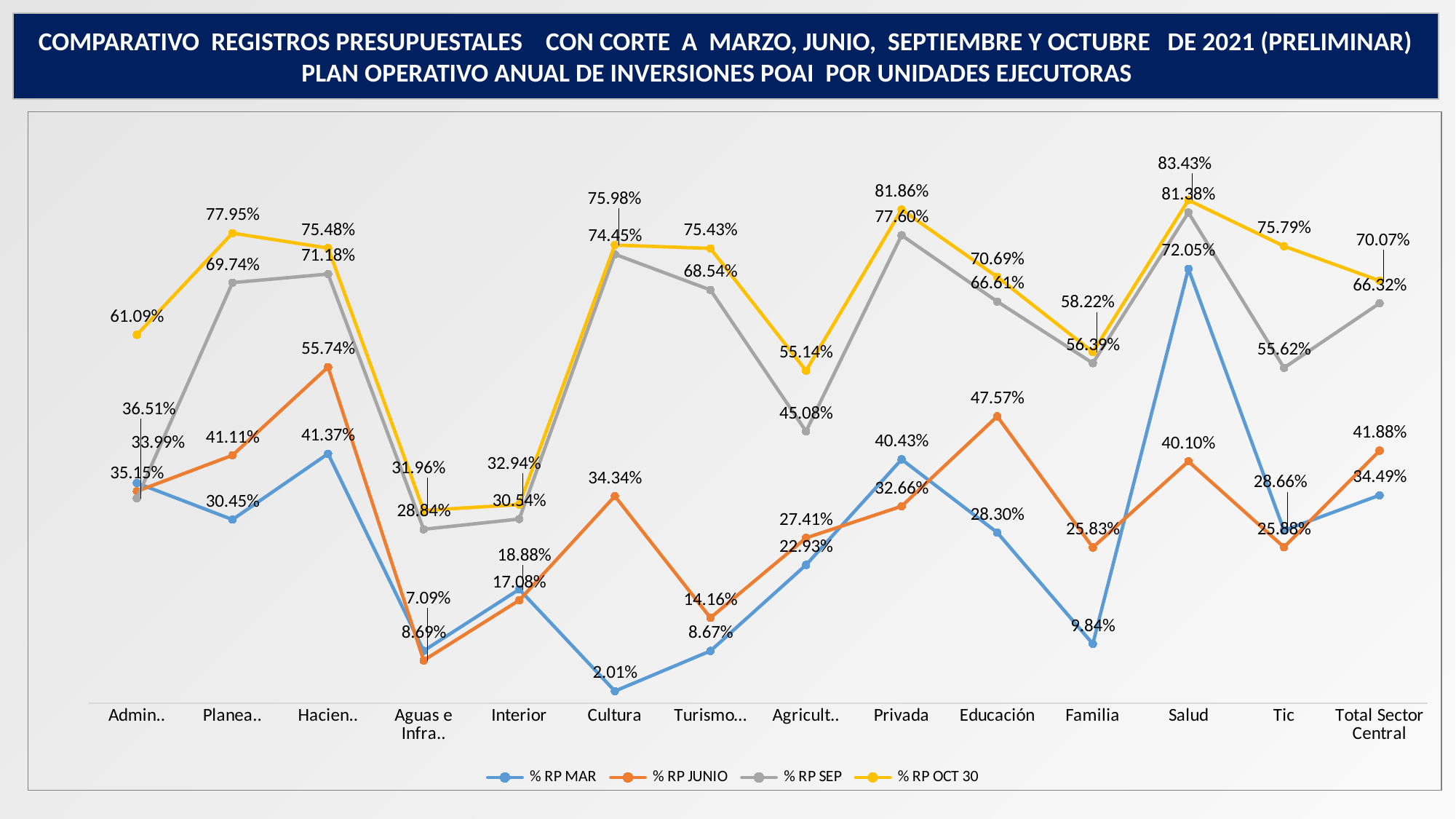
Which category has the lowest % RP MAR value? Cultura How many series does the legend list? 4 What is the difference between the % RP OCT 30 and % RP SEP values for Salud? 2.05 percentage points What colour is the % RP OCT 30 line? Yellow How many categories are shown along the x axis? 14 What kind of chart is shown on the slide? Line chart Which category has the highest % RP OCT 30 value? Salud What is the % RP SEP value for Planea..? 69.74% What is the % RP JUNIO value for Total Sector Central? 41.88% For Educación, which is larger: the % RP JUNIO value or the % RP MAR value? % RP JUNIO What is the % RP MAR value for Cultura? 2.01% What is the % RP OCT 30 value for Salud? 83.43%